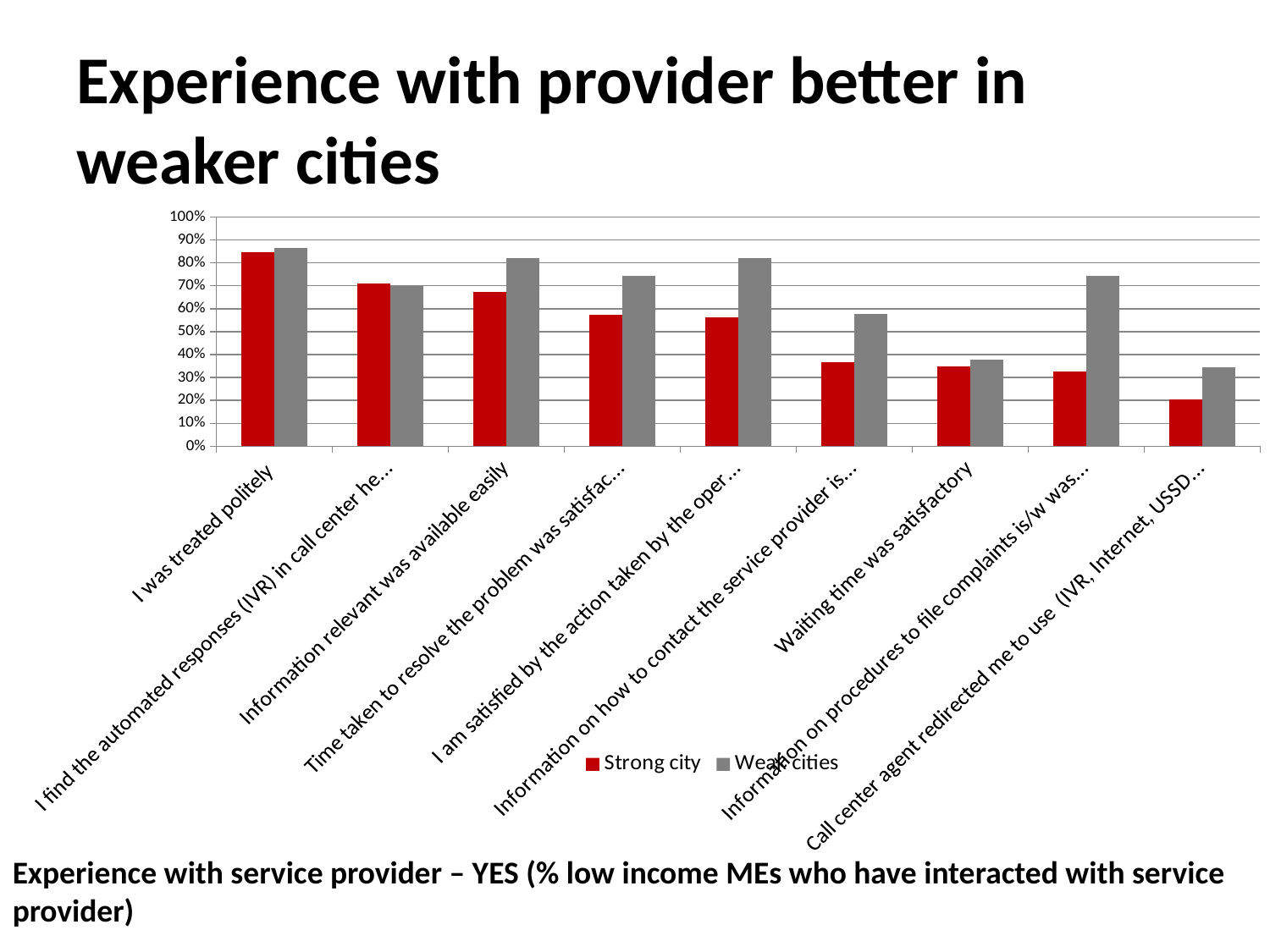
Which category has the highest value for the Strong city series? I was treated politely Is the Weak cities value for 'Waiting time was satisfactory' greater or less than 50%? less How many series does the legend list? 2 What are the two series named in the legend? Strong city and Weak cities For 'Information relevant was available easily', which series has the larger value, Strong city or Weak cities? Weak cities Do the Strong city values generally rise or fall from left to right along the x axis? fall Is the Strong city value for 'Waiting time was satisfactory' greater or less than 40%? less What colour are the bars for the Strong city series? Red Is the Weak cities value for 'I was treated politely' greater or less than 80%? greater What type of chart is shown on the slide? Bar chart How many categories are plotted along the x axis? 9